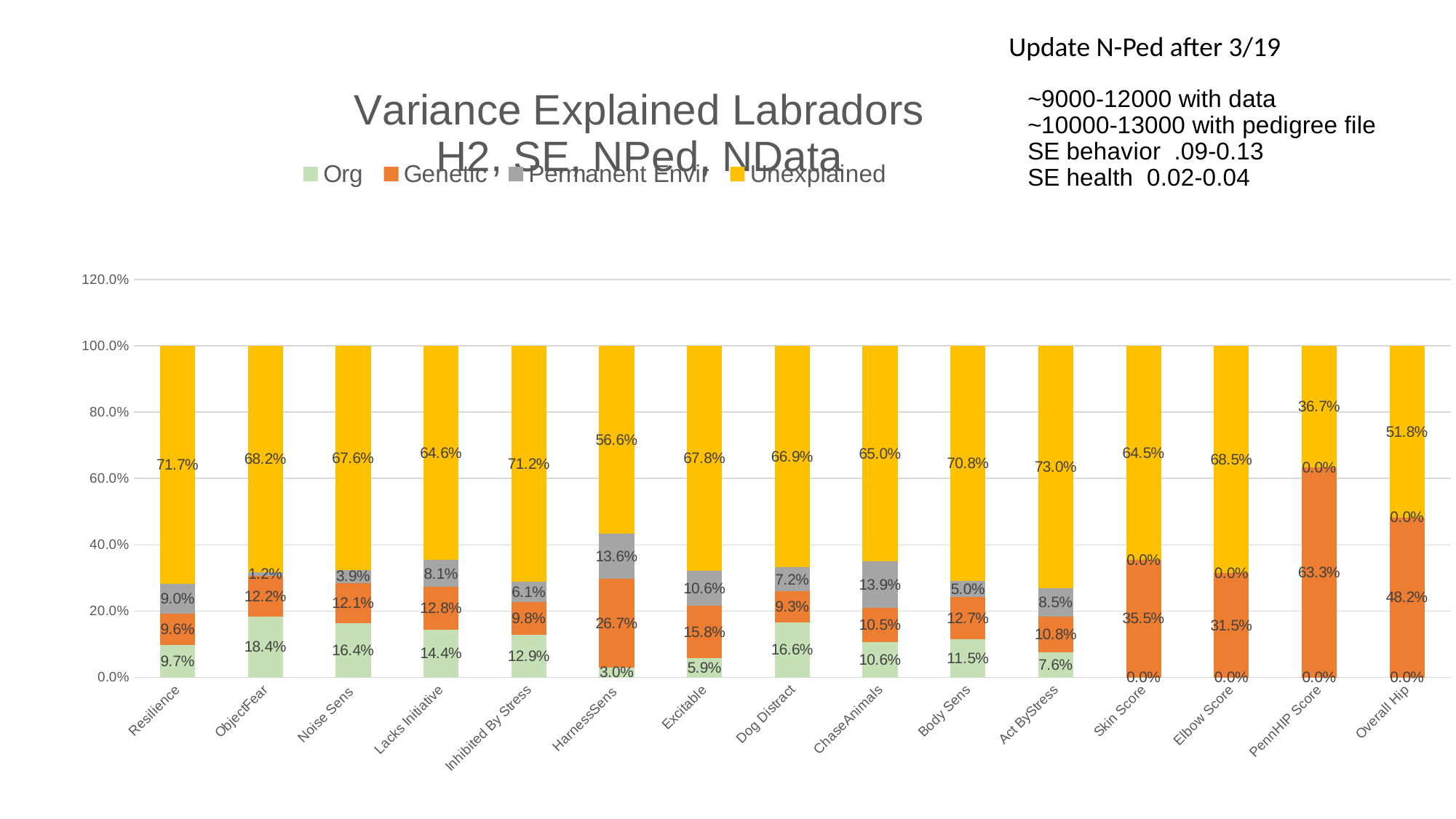
How many categories are plotted along the x axis? 15 How many series does the legend list? 4 What is the Unexplained value for Resilience? 71.7% What is the Org value for ObjectFear? 18.4% What is the difference between the Genetic values for PennHIP Score and Overall Hip? 15.1% Which category has the lowest Unexplained value? PennHIP Score Which is larger, the Org value for Noise Sens or the Org value for Dog Distract? Dog Distract What kind of chart is shown on the slide? Stacked bar chart What is the Genetic value for HarnessSens? 26.7% What is the Permanent Envir value for ChaseAnimals? 13.9% What is the total of the stacked bar for Skin Score? 100.0% Which category has the highest Genetic value? PennHIP Score